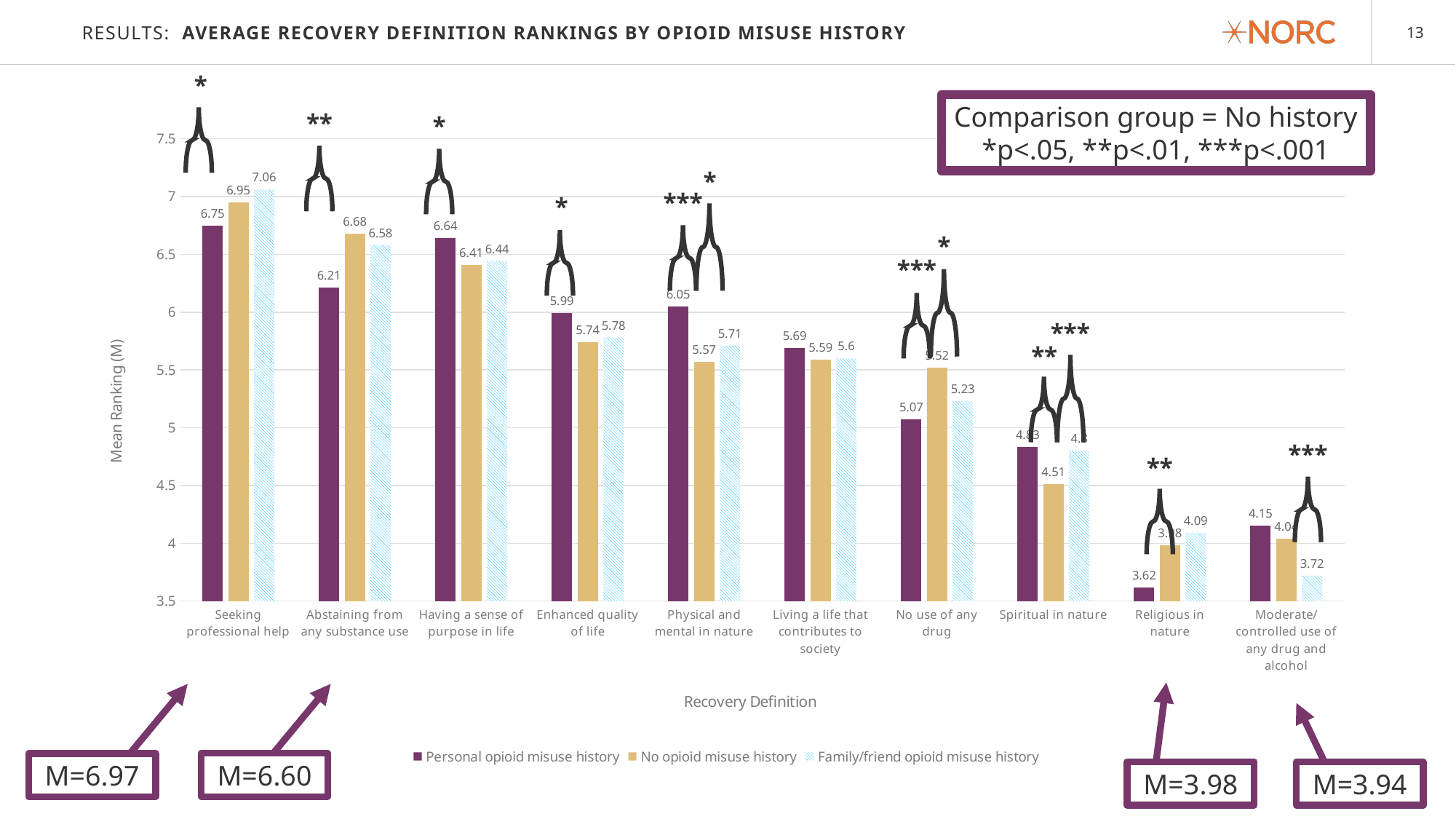
How many recovery definitions are shown on the x axis? 10 What is the mean ranking for 'Physical and mental in nature' in the No opioid misuse history series? 5.57 How many series does the legend list? 3 Which recovery definition has the highest mean ranking in the Personal opioid misuse history series? Seeking professional help What is the difference between the Personal opioid misuse history and No opioid misuse history mean rankings for 'Physical and mental in nature'? 0.48 For 'Abstaining from any substance use', which series has the larger mean ranking: Personal opioid misuse history or No opioid misuse history? No opioid misuse history What kind of chart is shown on the slide? Bar chart Is the Personal opioid misuse history mean ranking for 'No use of any drug' greater or less than 5.5? less Which recovery definition has the lowest mean ranking in the Family/friend opioid misuse history series? Moderate/controlled use of any drug and alcohol What is the mean ranking for 'Abstaining from any substance use' in the Personal opioid misuse history series? 6.21 What is the mean ranking for 'Seeking professional help' in the Family/friend opioid misuse history series? 7.06 What is the mean ranking for 'Religious in nature' in the Personal opioid misuse history series? 3.62